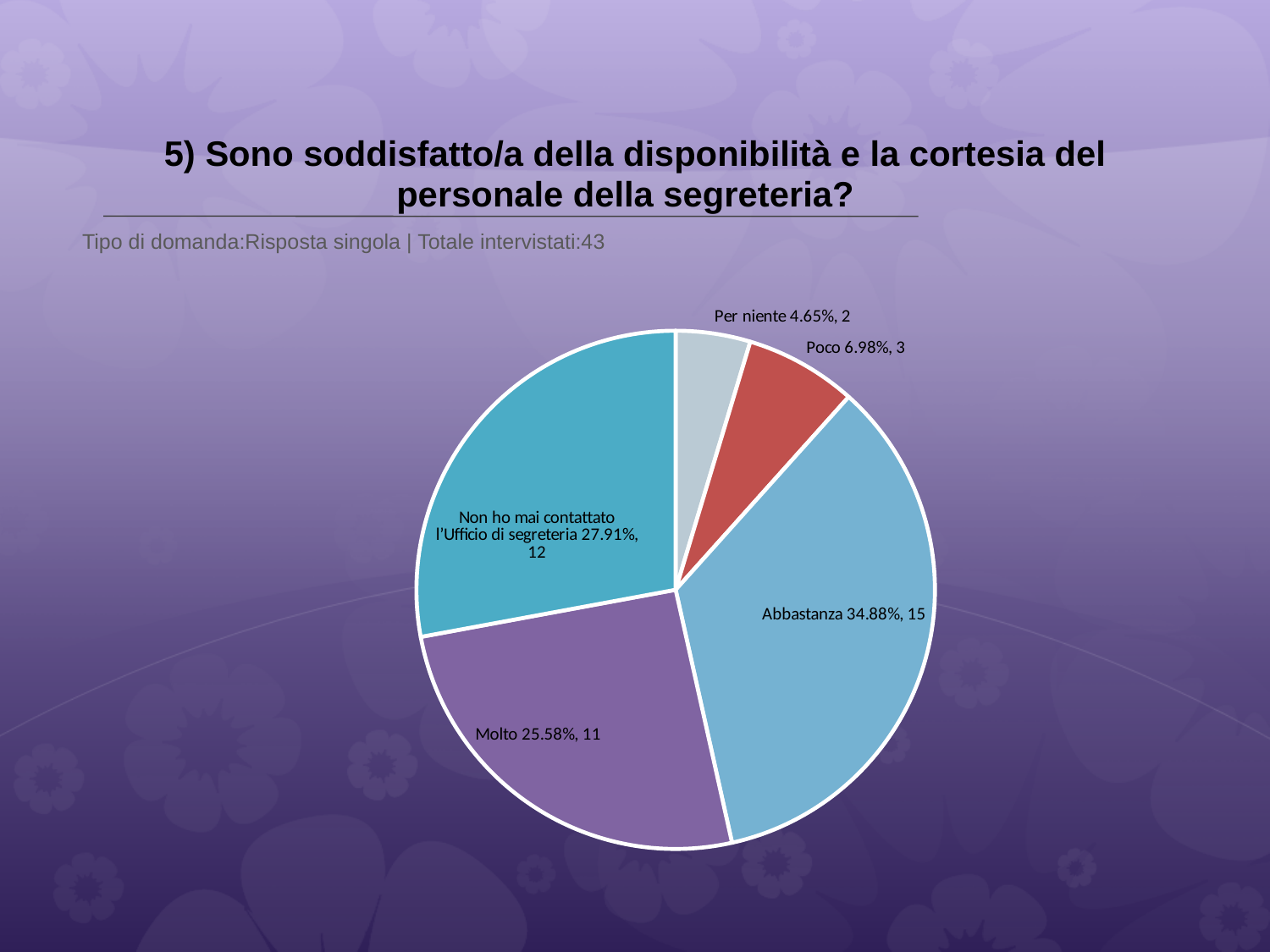
Which category has the largest slice of the pie? Abbastanza What is the total number of respondents shown on the slide? 43 How many slices does the pie chart have? 5 Which has more respondents, 'Poco' or 'Per niente'? Poco What percentage share does the 'Abbastanza' slice represent? 34.88% Which category has the smallest slice of the pie? Per niente How many respondents answered 'Per niente'? 2 What kind of chart is shown on the slide? pie chart How many respondents answered 'Molto'? 11 What percentage share does the 'Non ho mai contattato l'Ufficio di segreteria' slice represent? 27.91% What colour is the 'Poco' slice? red What is the difference in respondent count between 'Abbastanza' and 'Molto'? 4